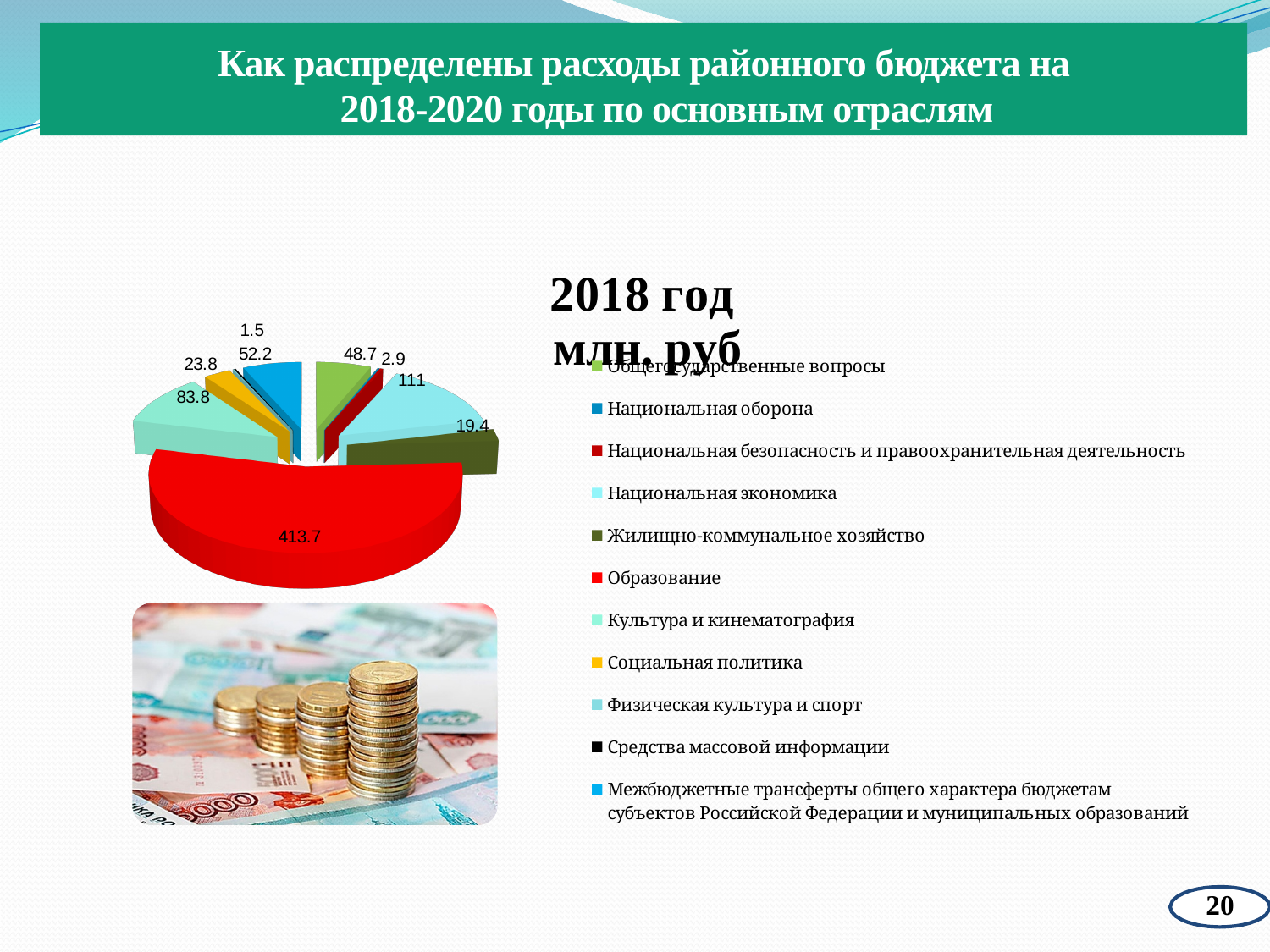
What kind of chart is shown on the slide? pie chart What is the difference between the values for Культура и кинематография and Социальная политика? 60 What is the value shown for Жилищно-коммунальное хозяйство in the pie chart? 19.4 What is the value shown for Образование in the pie chart? 413.7 What is the value shown for Национальная экономика in the pie chart? 111 Which category has the largest slice in the pie chart? Образование What is the value shown for Культура и кинематография in the pie chart? 83.8 What is the difference between the values for Образование and Национальная экономика? 302.7 Which is larger in the pie chart: Образование or Национальная экономика? Образование What is the value shown for Общегосударственные вопросы in the pie chart? 48.7 How many entries does the legend of the pie chart list? 11 Which year and unit are stated next to the pie chart? 2018 год, млн. руб